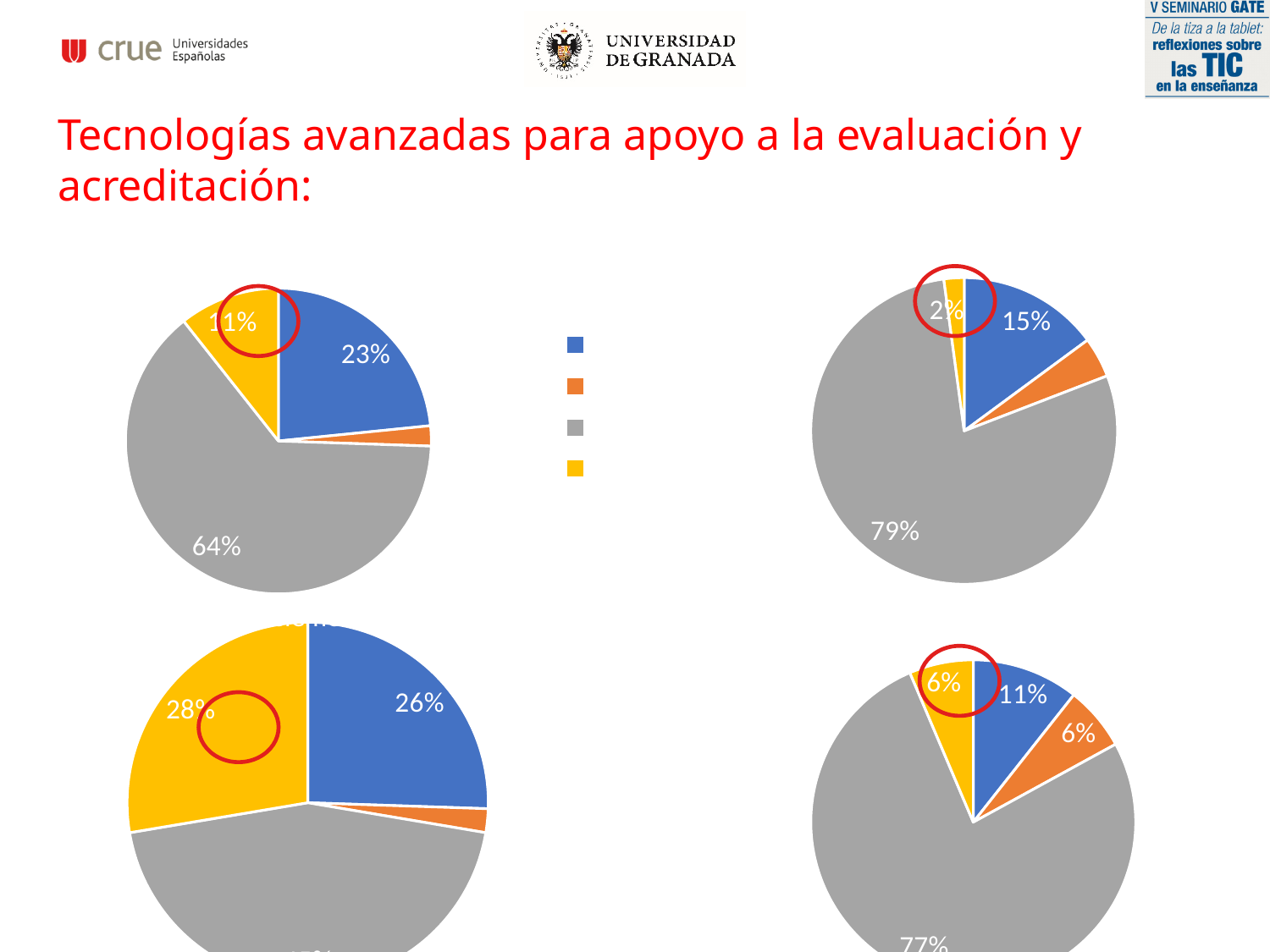
How many pie charts are on the slide? 4 In the top-right pie chart, which colour slice is the largest? Gray (79%) In the bottom-right pie chart, what share does the gray slice have? 77% What kind of charts are shown on the slide? Pie charts In the top-right pie chart, which colour slice is the smallest? Yellow (2%) In the top-left pie chart, what share does the gray slice have? 64% In the top-left pie chart, what share does the yellow slice have? 11% In the top-right pie chart, what share does the blue slice have? 15% In the bottom-left pie chart, which is larger, the blue slice or the yellow slice? Yellow (28%) How many colour entries does the legend in the middle of the slide show? 4 In the top-left pie chart, what share does the blue slice have? 23% In the bottom-right pie chart, what is the difference between the gray slice and the blue slice? 66 percentage points